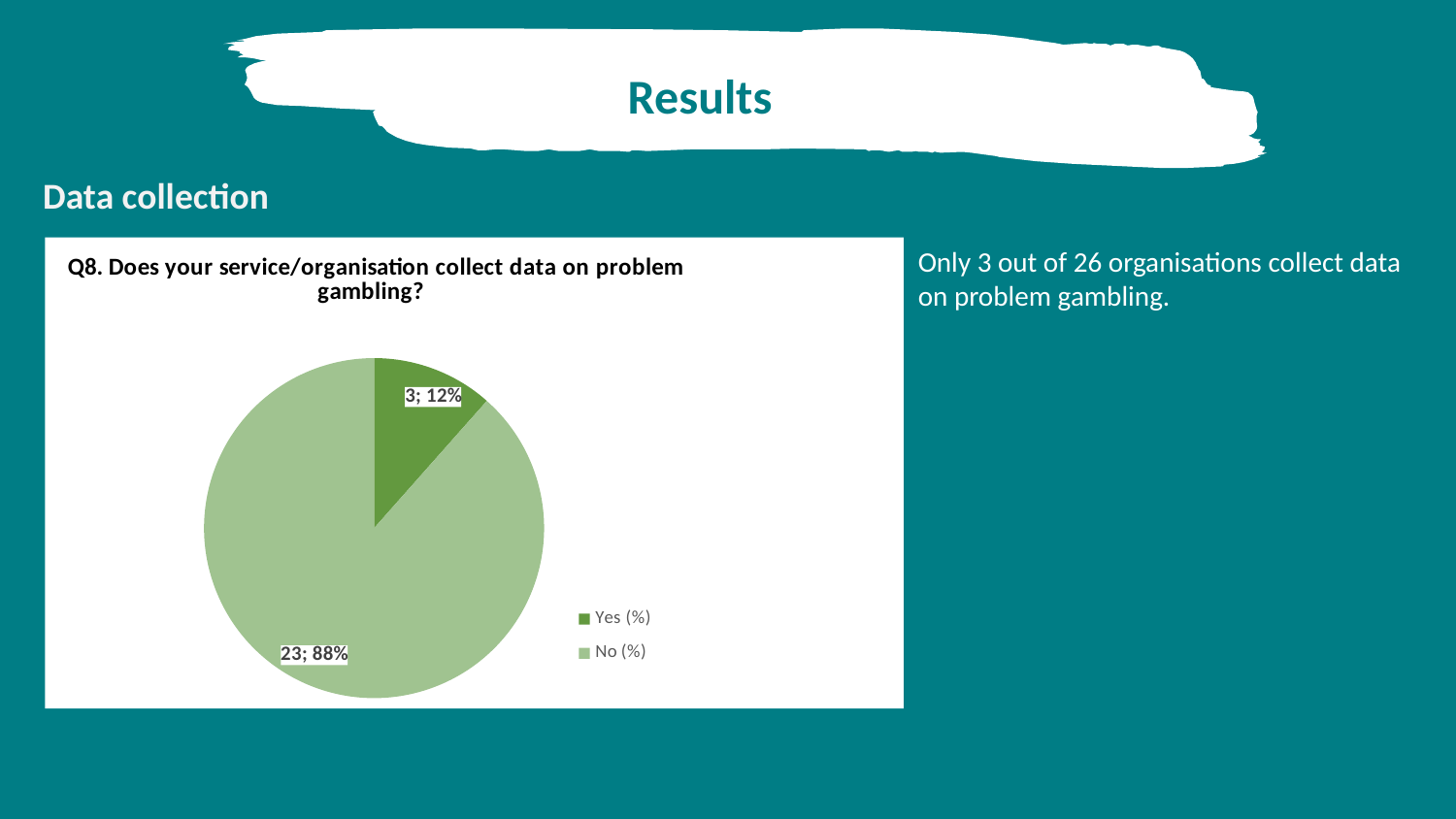
What is the title of the pie chart? Q8. Does your service/organisation collect data on problem gambling? How many slices does the pie chart have? 2 What percentage of the pie does the "Yes (%)" slice represent? 12% How many organisations answered "No" to collecting data on problem gambling? 23 What kind of chart is shown on the slide? Pie chart How many organisations answered "Yes" to collecting data on problem gambling? 3 Which slice is the largest in the pie chart? No (%) What percentage of the pie does the "No (%)" slice represent? 88% Which slice is the smallest in the pie chart? Yes (%) What is the total number of responses shown in the pie chart? 26 Which response has the larger count, "Yes" or "No"? No What is the difference in count between the "No" and "Yes" responses? 20